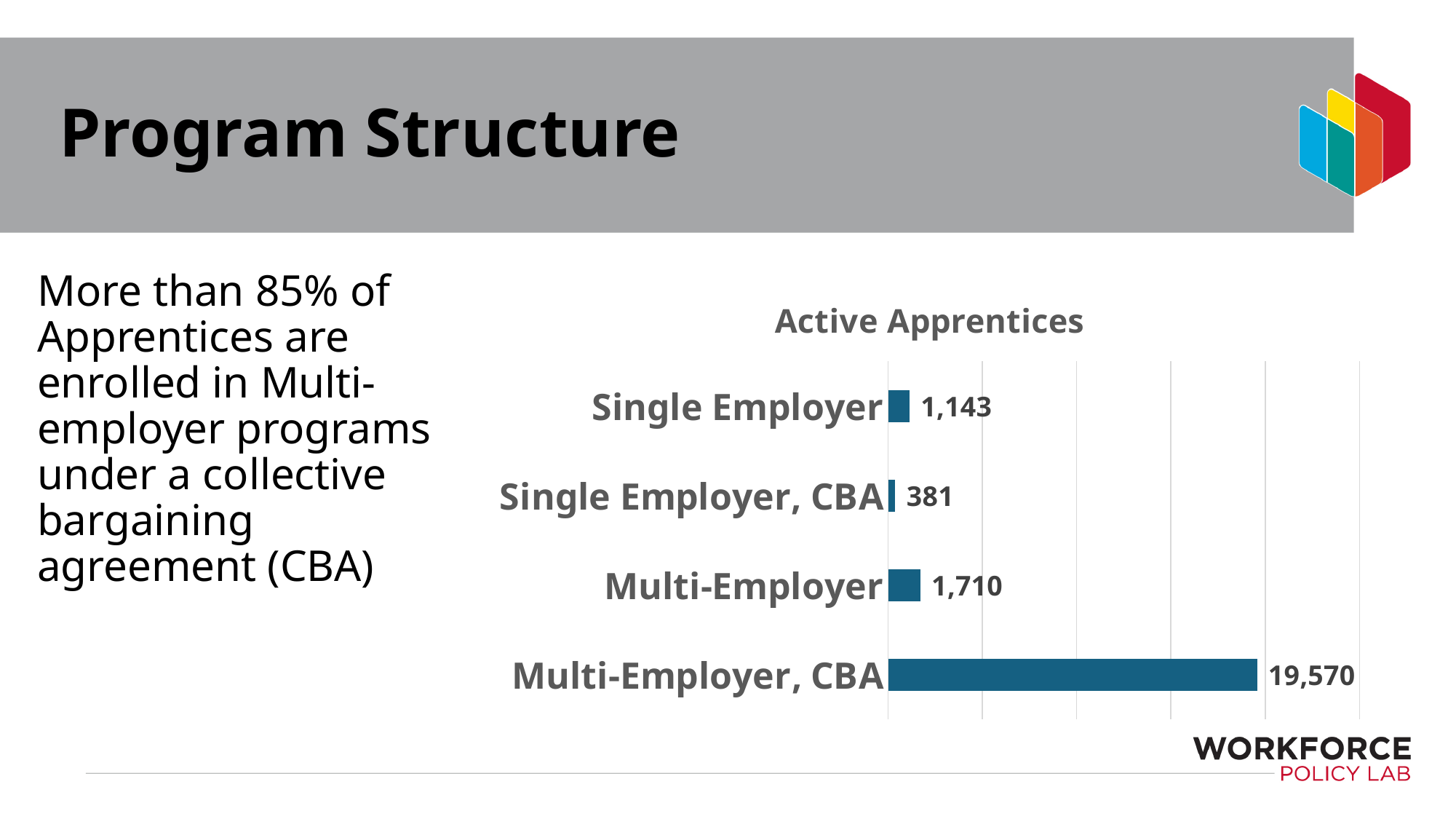
What kind of chart is shown on the slide? Bar chart Which category has the highest number of active apprentices? Multi-Employer, CBA Which is larger, the value for Multi-Employer or the value for Single Employer? Multi-Employer What is the value for Single Employer in the Active Apprentices chart? 1,143 Which category has the lowest number of active apprentices? Single Employer, CBA What is the value for Single Employer, CBA in the Active Apprentices chart? 381 What is the difference between the Multi-Employer, CBA value and the Multi-Employer value? 17,860 What is the title of the chart on the slide? Active Apprentices What is the value for Multi-Employer in the Active Apprentices chart? 1,710 What is the value for Multi-Employer, CBA in the Active Apprentices chart? 19,570 How many categories are shown in the Active Apprentices chart? 4 What is the difference between the Single Employer value and the Single Employer, CBA value? 762